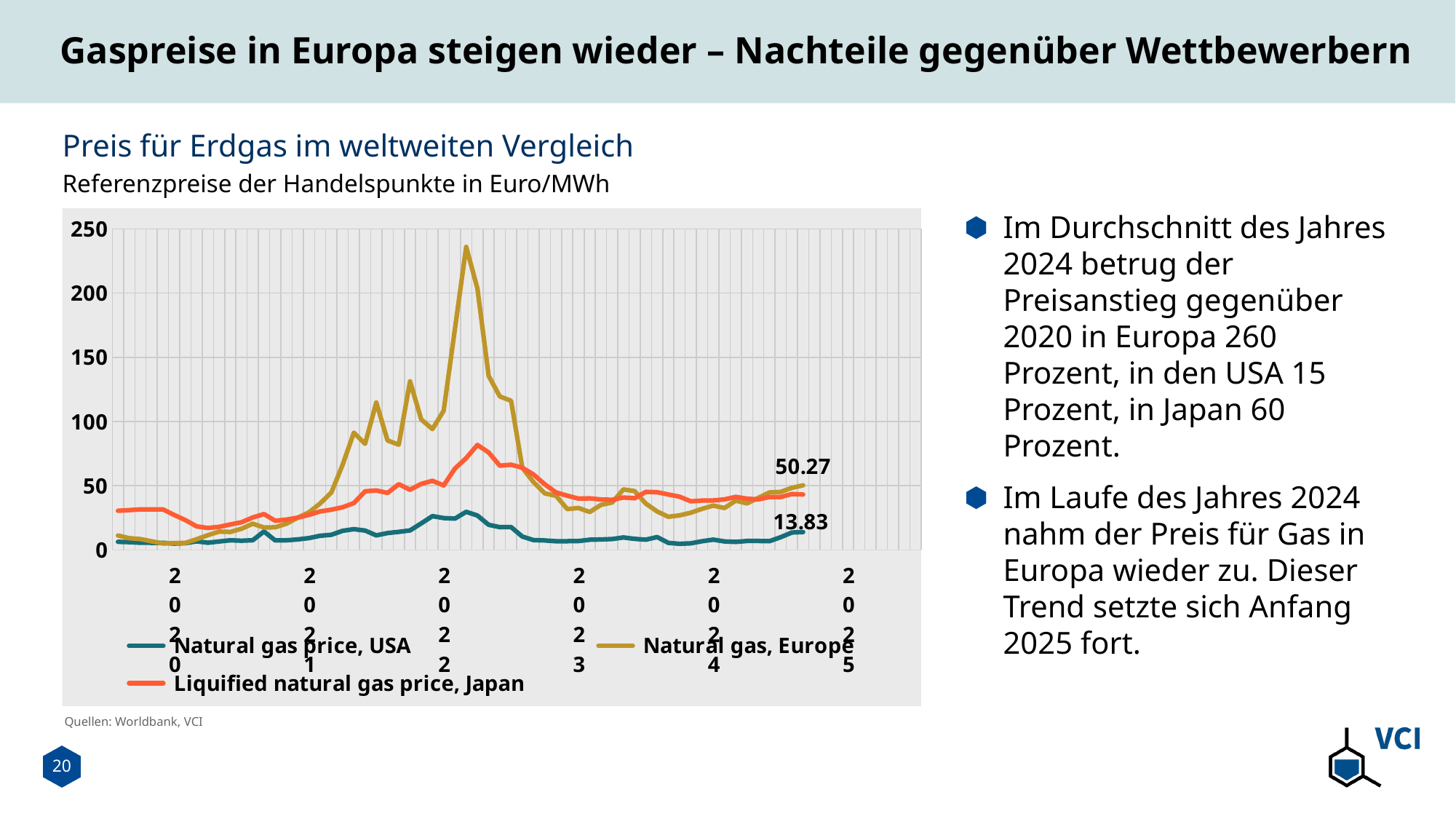
How many series does the chart legend list? 3 Is the highest value of the 'Natural gas price, USA' series greater or less than 50? less What kind of chart is shown on the slide? line chart How many year labels are shown on the x axis? 6 Which series reaches the highest peak in the chart? Natural gas, Europe In what unit are the prices in the chart given, according to the subtitle? Euro/MWh What is the difference between the last labelled values of the Europe series (50.27) and the USA series (13.83)? 36.44 At the end of the chart, which is larger: the labelled value for Europe or for the USA? Natural gas, Europe What is the last labelled value of the 'Natural gas, Europe' series? 50.27 Is the peak value of the 'Natural gas, Europe' series greater or less than 200? greater What is the last labelled value of the 'Natural gas price, USA' series? 13.83 Which series is the lowest at the right end of the chart? Natural gas price, USA